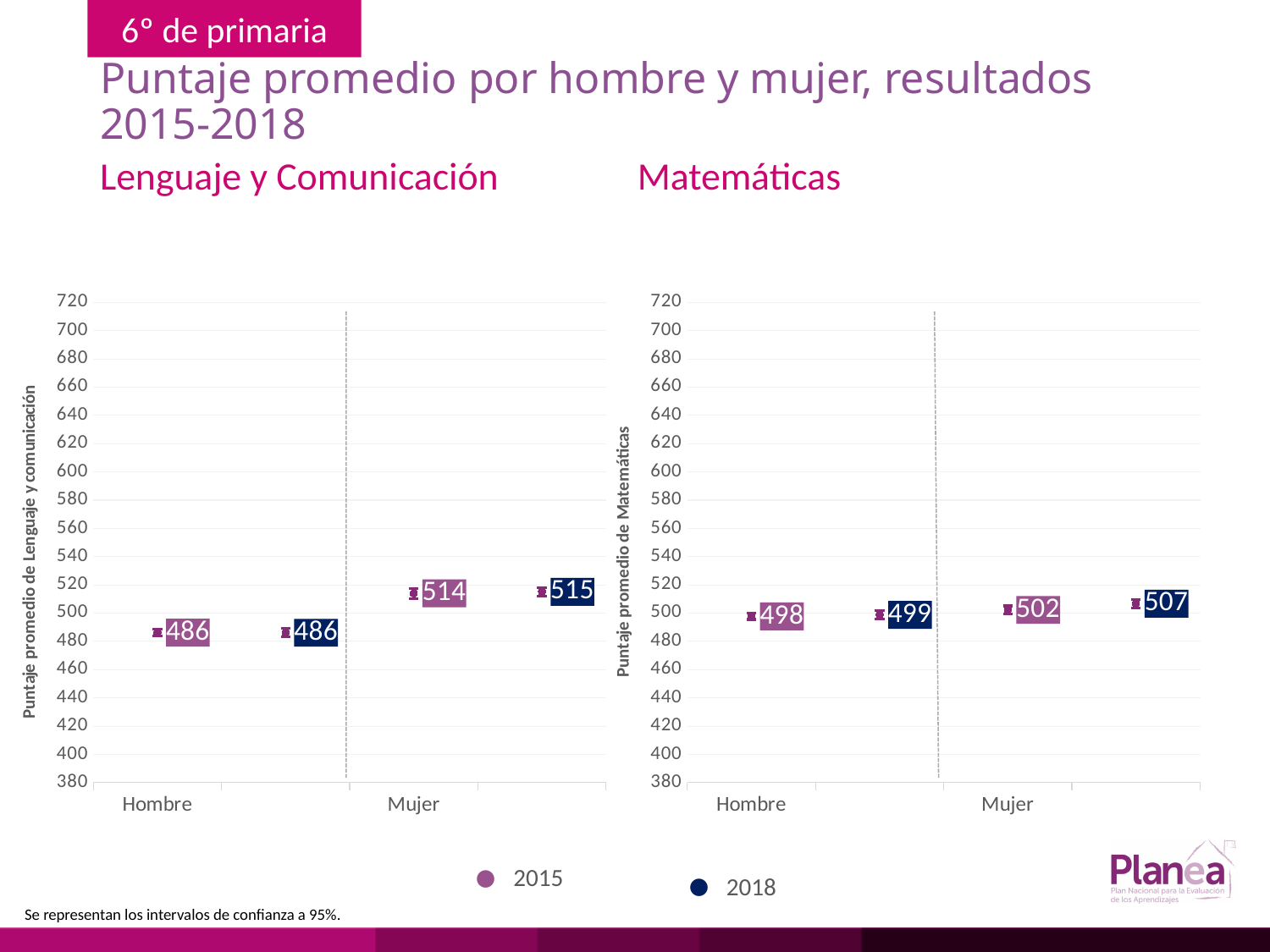
In the Lenguaje y Comunicación chart, what is the 2015 value for Hombre? 486 In the Lenguaje y Comunicación chart, what is the difference between the 2015 values for Mujer and Hombre? 28 In the Matemáticas chart, what is the difference between the 2018 values for Mujer and Hombre? 8 How many categories are shown on the x axis of the Matemáticas chart? 2 In the Matemáticas chart, what is the 2018 value for Mujer? 507 In the Lenguaje y Comunicación chart, what is the 2018 value for Mujer? 515 How many series does the legend list? 2 What is the y-axis title of the Matemáticas chart? Puntaje promedio de Matemáticas In the Matemáticas chart, is the 2015 value for Mujer larger or smaller than the 2018 value for Mujer? smaller In the Matemáticas chart, which category has the lowest 2015 value? Hombre In the Matemáticas chart, what is the 2015 value for Hombre? 498 In the Lenguaje y Comunicación chart, which category has the highest 2018 value? Mujer